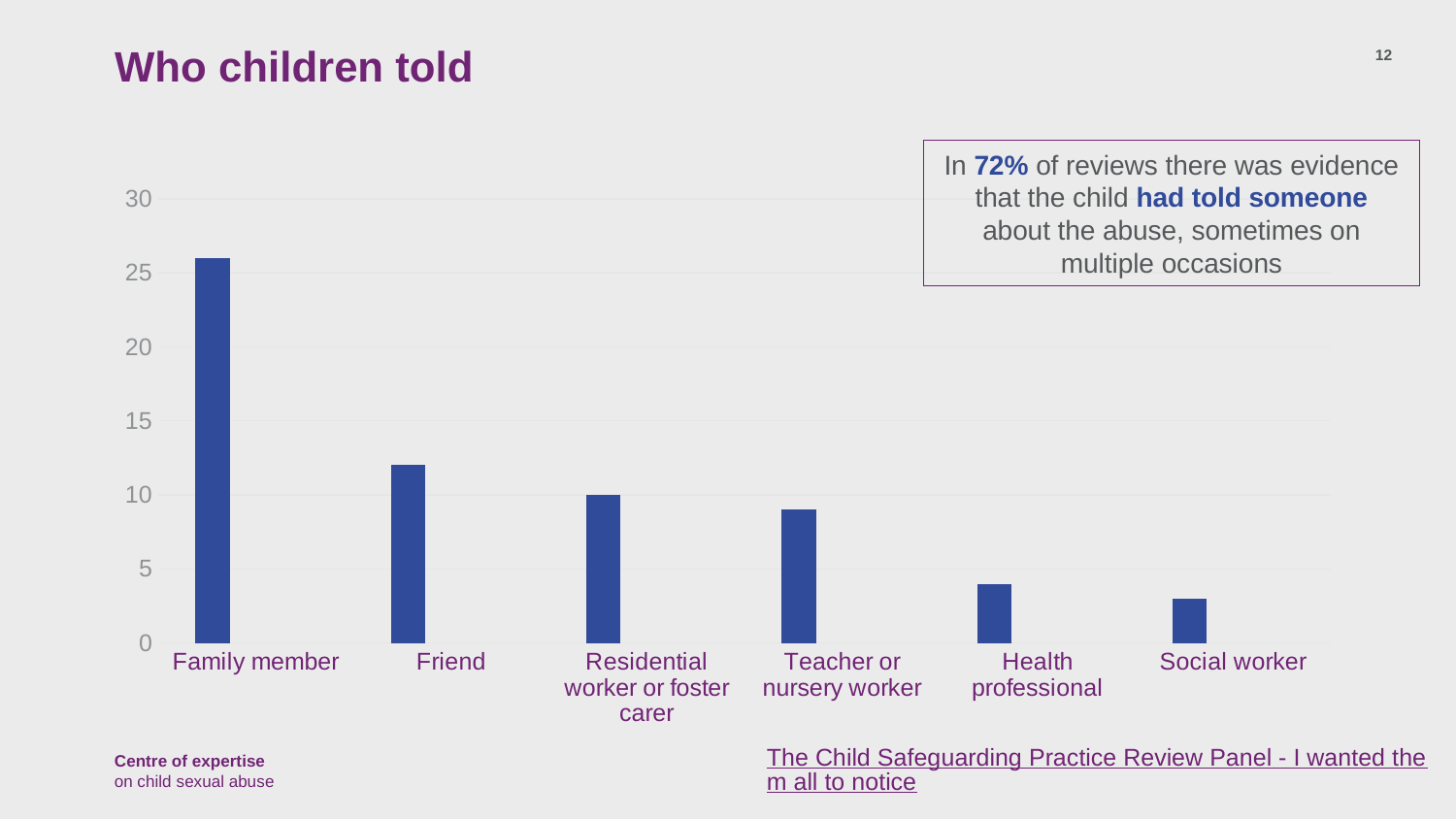
Do the bar values rise or fall from left to right across the categories? fall What is the value for Residential worker or foster carer? 10 Is the value for Friend greater or less than 15? less Which category has the highest bar in the chart? Family member Is the value for Teacher or nursery worker greater or less than 5? greater What is the title of the slide containing the chart? Who children told How many categories are shown on the x axis of the chart? 6 Is the value for Health professional greater or less than 5? less Which category has the lowest bar in the chart? Social worker What kind of chart is shown on the slide? bar chart Which is larger, the value for Friend or the value for Teacher or nursery worker? Friend